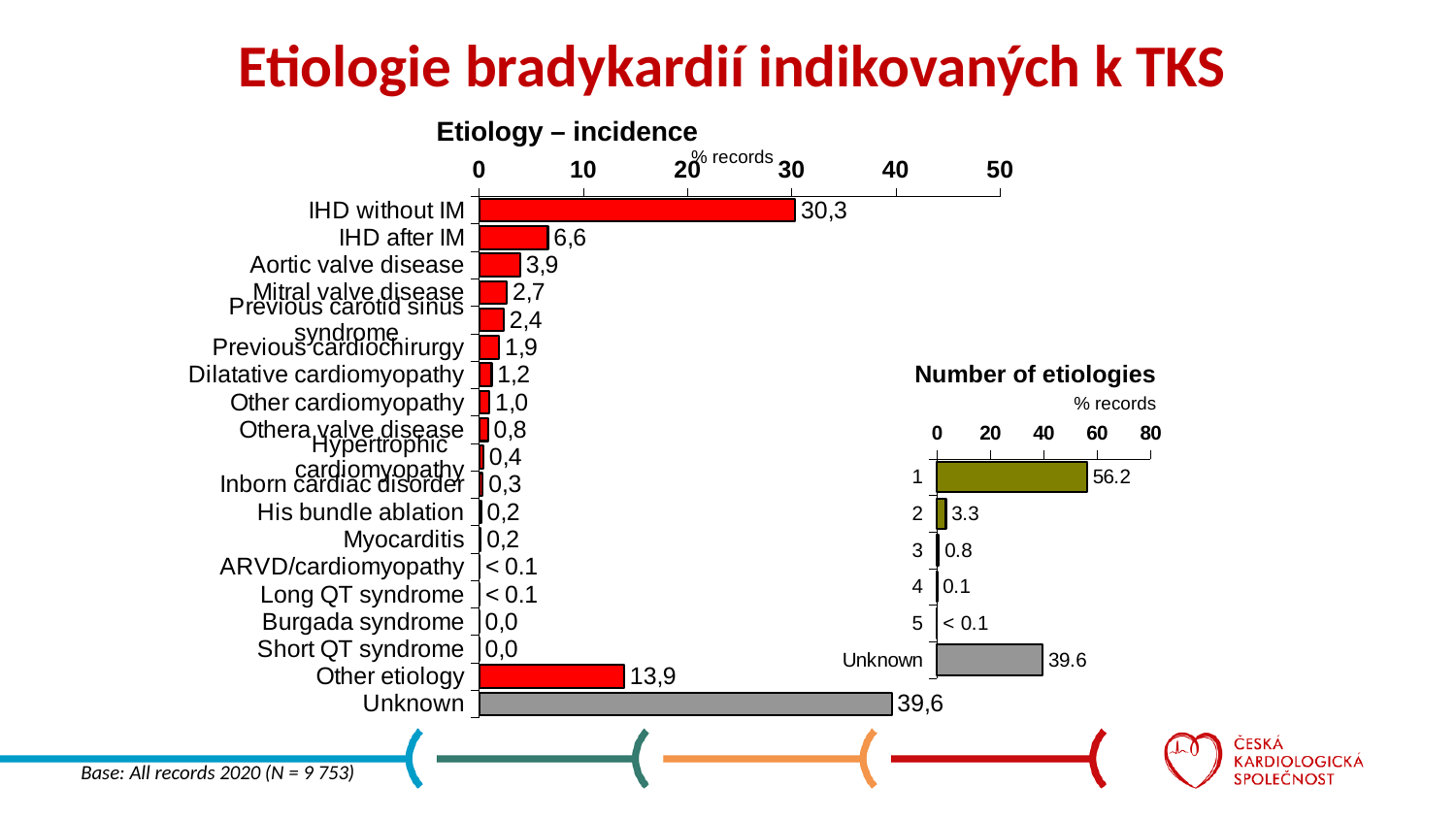
In the "Etiology – incidence" chart, which is larger, the value for Mitral valve disease or the value for Previous cardiochirurgy? Mitral valve disease In the "Etiology – incidence" chart, how many categories are plotted? 19 In the "Etiology – incidence" chart, which category has the highest value? Unknown In the "Etiology – incidence" chart, what is the value for Aortic valve disease? 3,9 In the "Number of etiologies" chart, what is the difference between the values for 1 etiology and 2 etiologies? 52.9 In the "Number of etiologies" chart, what is the value for Unknown? 39.6 In the "Number of etiologies" chart, what is the value for 1 etiology? 56.2 In the "Etiology – incidence" chart, what is the value for Other etiology? 13,9 In the "Number of etiologies" chart, how many categories are plotted? 6 In the "Etiology – incidence" chart, what is the difference between the values for IHD without IM and IHD after IM? 23,7 In the "Etiology – incidence" chart, what is the value for IHD without IM? 30,3 What kind of chart is the "Number of etiologies" chart? Bar chart